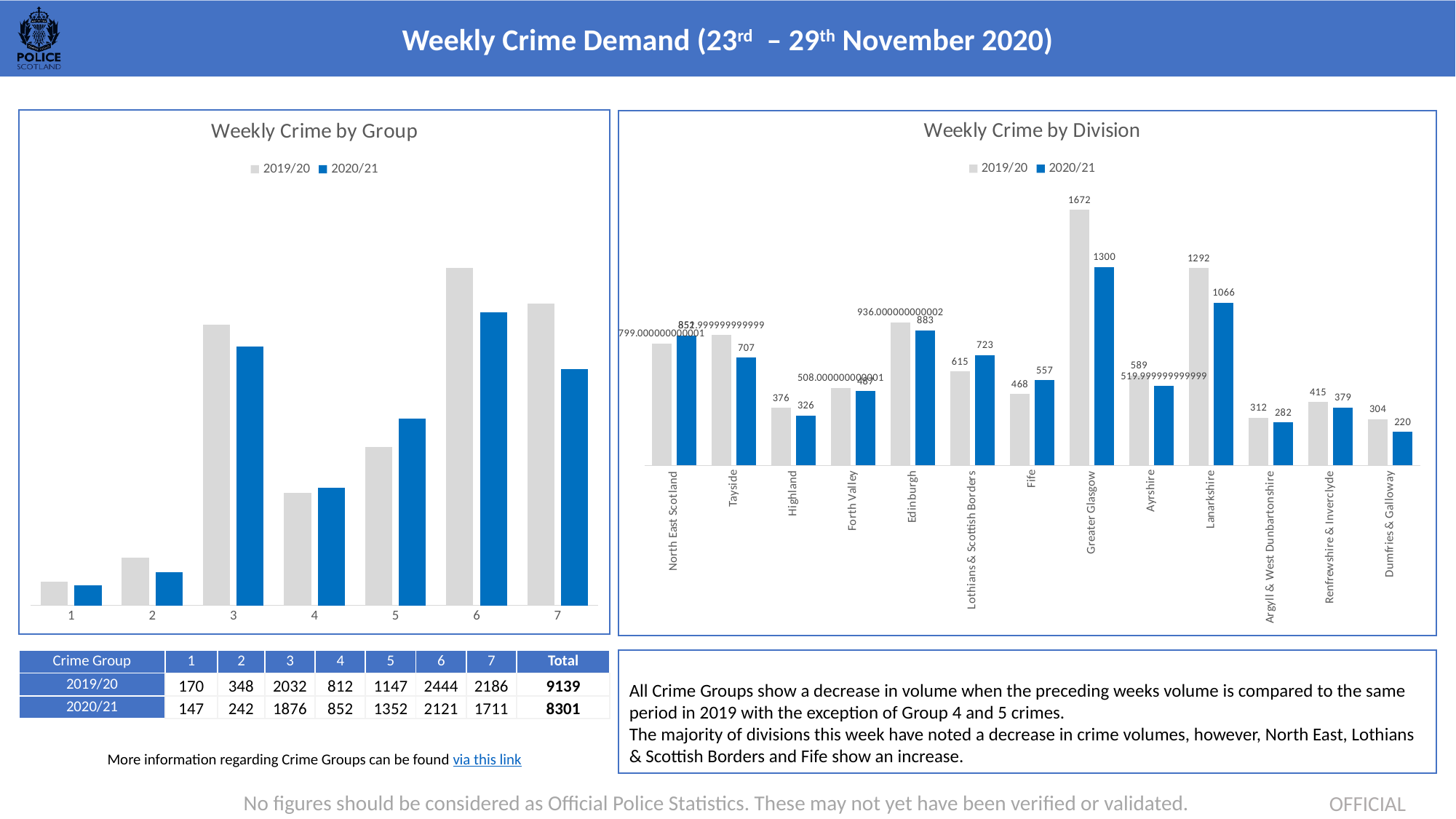
What kind of chart is the 'Weekly Crime by Division' chart? bar chart In the 'Weekly Crime by Division' chart, what is the 2020/21 value for Lanarkshire? 1066 In the 'Weekly Crime by Division' chart, which division has the lowest 2020/21 value? Dumfries & Galloway In the 'Weekly Crime by Division' chart, what is the difference between the 2019/20 and 2020/21 values for Greater Glasgow? 372 In the 'Weekly Crime by Group' chart, which colour represents the 2020/21 series? blue How many divisions are shown on the x axis of the 'Weekly Crime by Division' chart? 13 In the 'Weekly Crime by Division' chart, which division has the highest 2019/20 value? Greater Glasgow In the 'Weekly Crime by Division' chart, is the 2020/21 value for Lothians & Scottish Borders larger or smaller than its 2019/20 value? larger In the 'Weekly Crime by Group' chart, which crime group has the highest 2019/20 bar? 6 How many series does the legend of the 'Weekly Crime by Group' chart list? 2 In the 'Weekly Crime by Division' chart, what is the 2019/20 value for Greater Glasgow? 1672 In the 'Weekly Crime by Division' chart, what is the 2020/21 value for Fife? 557